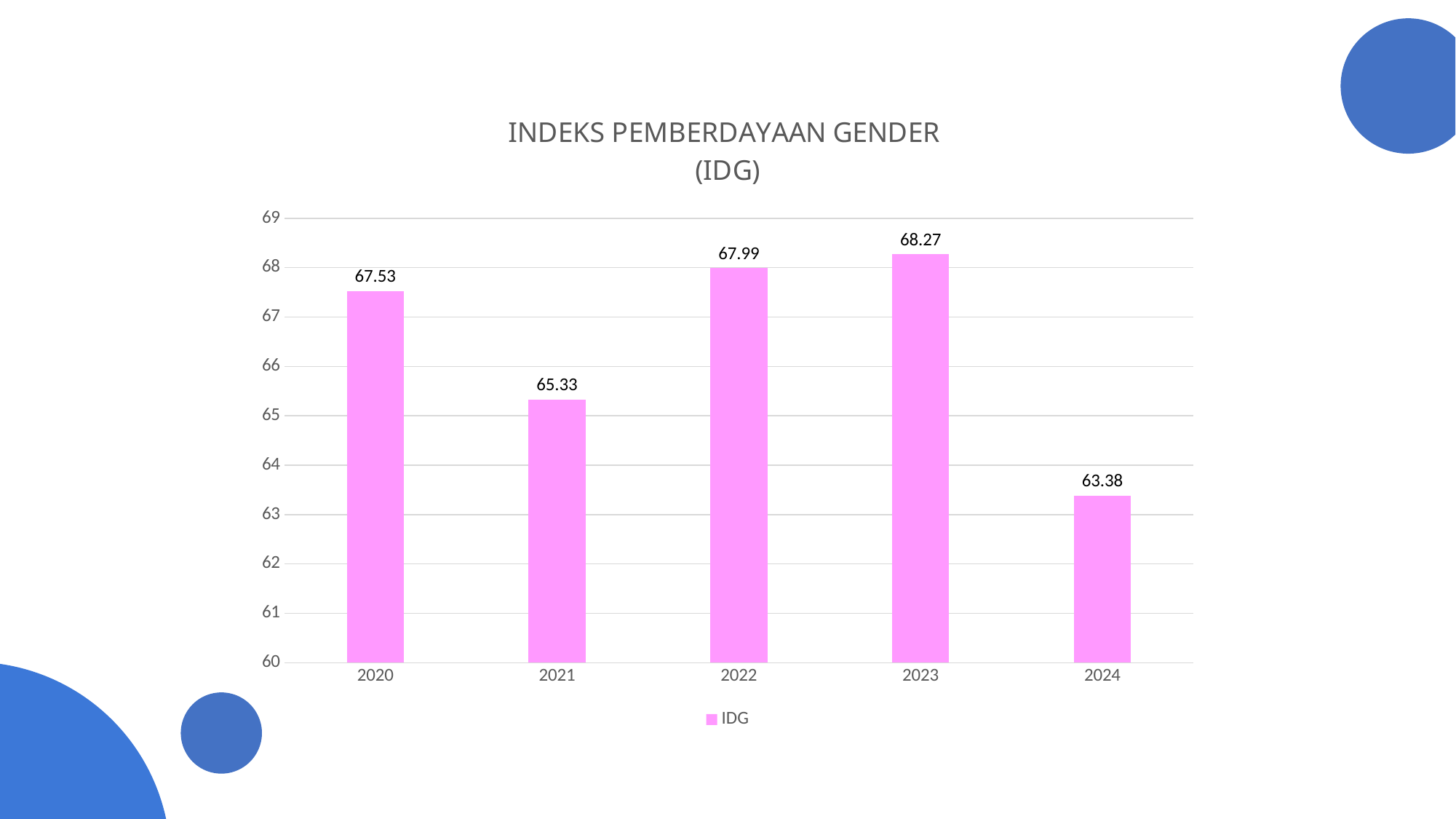
What is the IDG value for 2022? 67.99 How many series does the legend list? 1 What is the IDG value for 2024? 63.38 How many years are shown on the x axis? 5 What kind of chart is shown on the slide? bar chart What is the title of the chart? INDEKS PEMBERDAYAAN GENDER (IDG) What is the difference between the IDG values for 2023 and 2024? 4.89 Is the IDG value for 2021 greater or less than 66? less What is the IDG value for 2020? 67.53 Which year has the lowest IDG value? 2024 Which year has the highest IDG value? 2023 Which year has a larger IDG value, 2020 or 2021? 2020